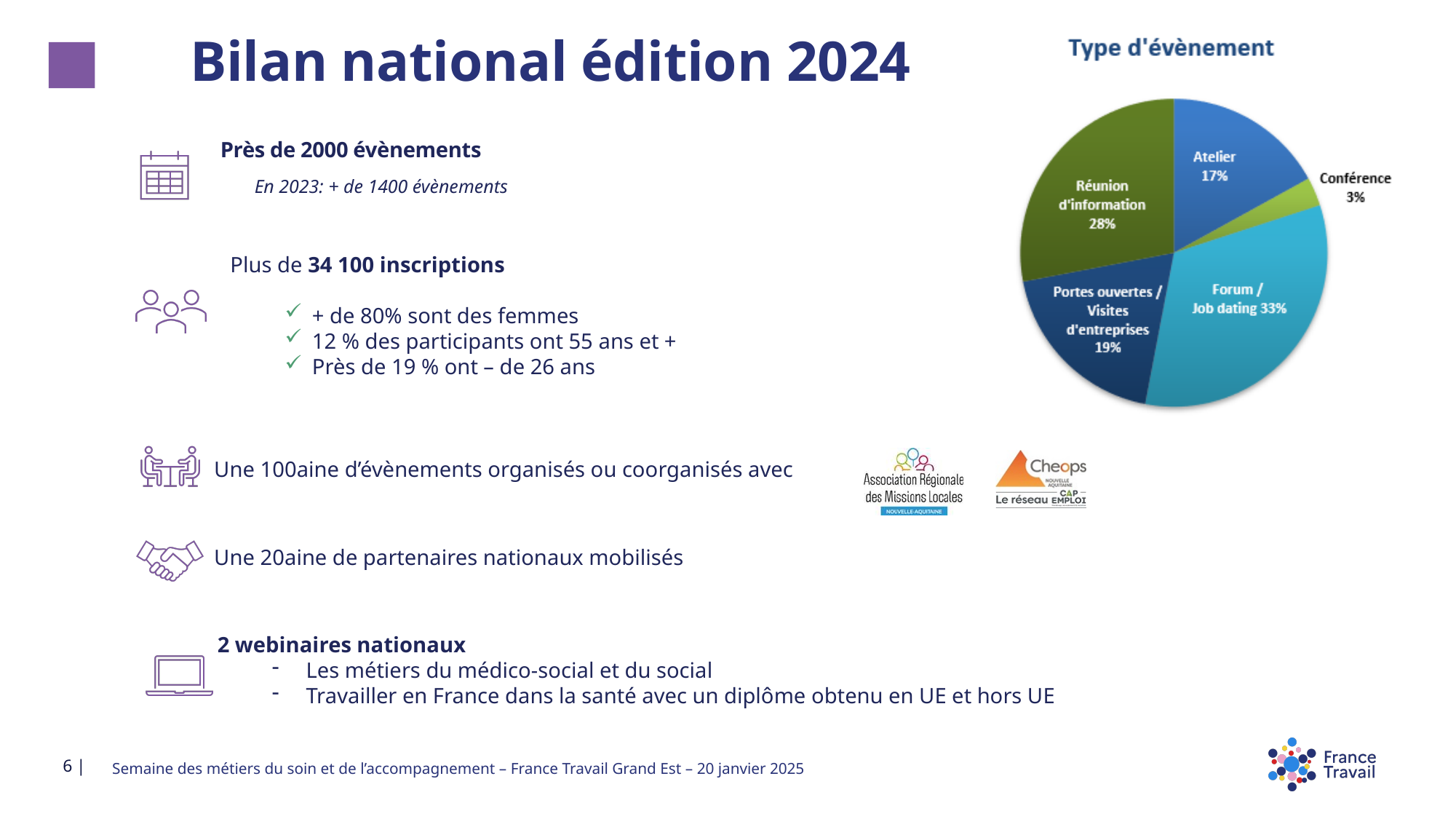
Which event type has the largest share in the pie chart? Forum / Job dating What percentage is shown for "Atelier" in the pie chart? 17% What type of chart is shown under the title "Type d'évènement"? pie chart What share of events does "Forum / Job dating" represent in the pie chart? 33% Which event type has the smallest share in the pie chart? Conférence What percentage is shown for "Portes ouvertes / Visites d'entreprises" in the pie chart? 19% What is the title of the chart on the slide? Type d'évènement How many event types are shown in the pie chart? 5 What percentage is shown for "Réunion d'information" in the pie chart? 28% What percentage is shown for "Conférence" in the pie chart? 3% What is the difference in percentage points between "Forum / Job dating" and "Réunion d'information" in the pie chart? 5 Which has a larger share in the pie chart, "Atelier" or "Portes ouvertes / Visites d'entreprises"? Portes ouvertes / Visites d'entreprises